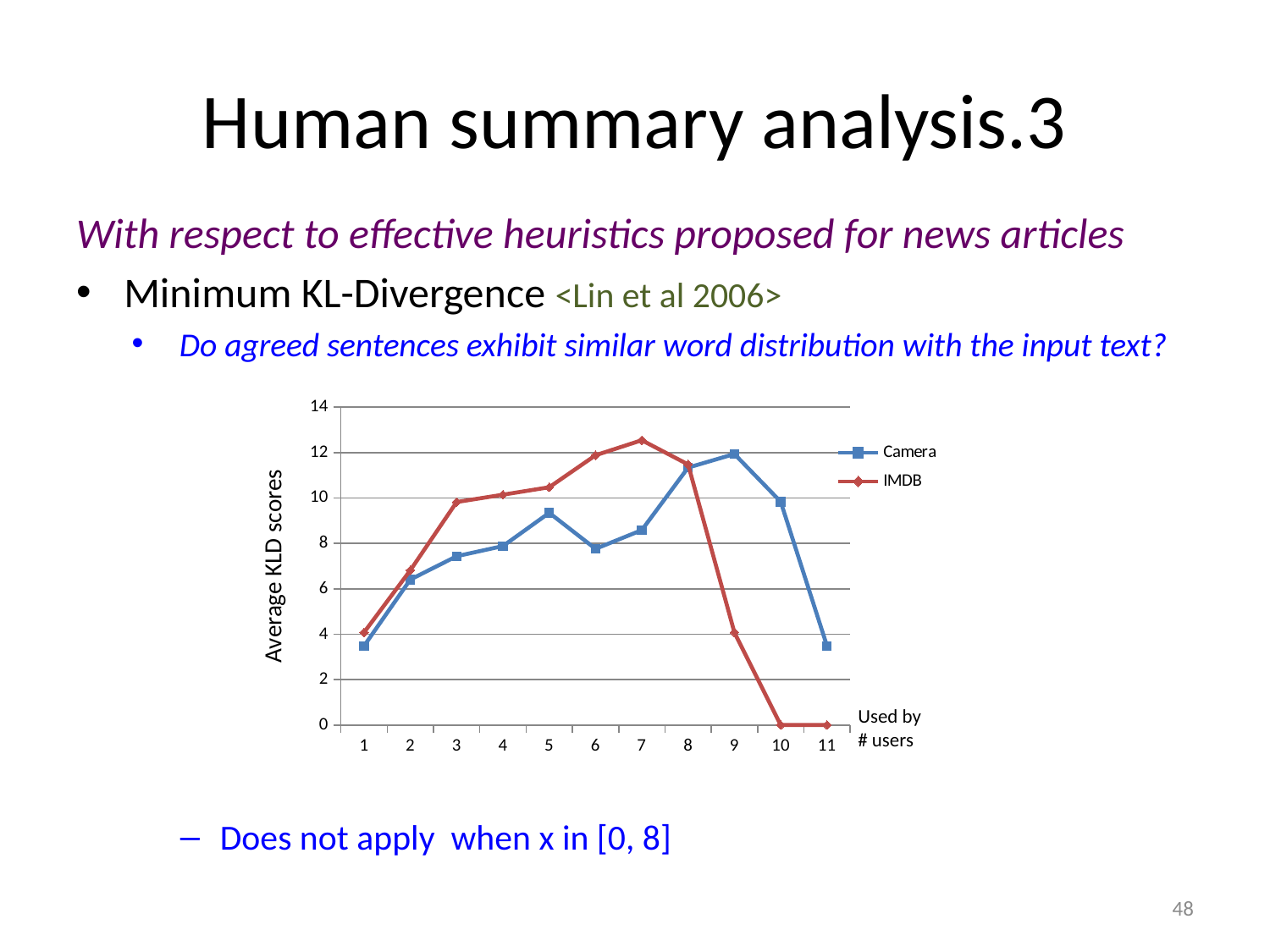
At x = 10, which series has the higher value, Camera or IMDB? Camera Is the value of the Camera series at x = 11 greater or less than 4? less What is the value of the IMDB series at x = 10? 0 Does the IMDB series rise or fall from x = 7 to x = 11? fall At x = 3, which series has the higher value, Camera or IMDB? IMDB What kind of chart is shown on the slide? line chart Is the value of the IMDB series at x = 3 greater or less than 8? greater At which x value does the IMDB series reach its highest value? 7 How many points are plotted along the x axis for each series? 11 How many series does the legend list? 2 At which x value does the Camera series reach its highest value? 9 Is the value of the Camera series at x = 5 greater or less than 8? greater